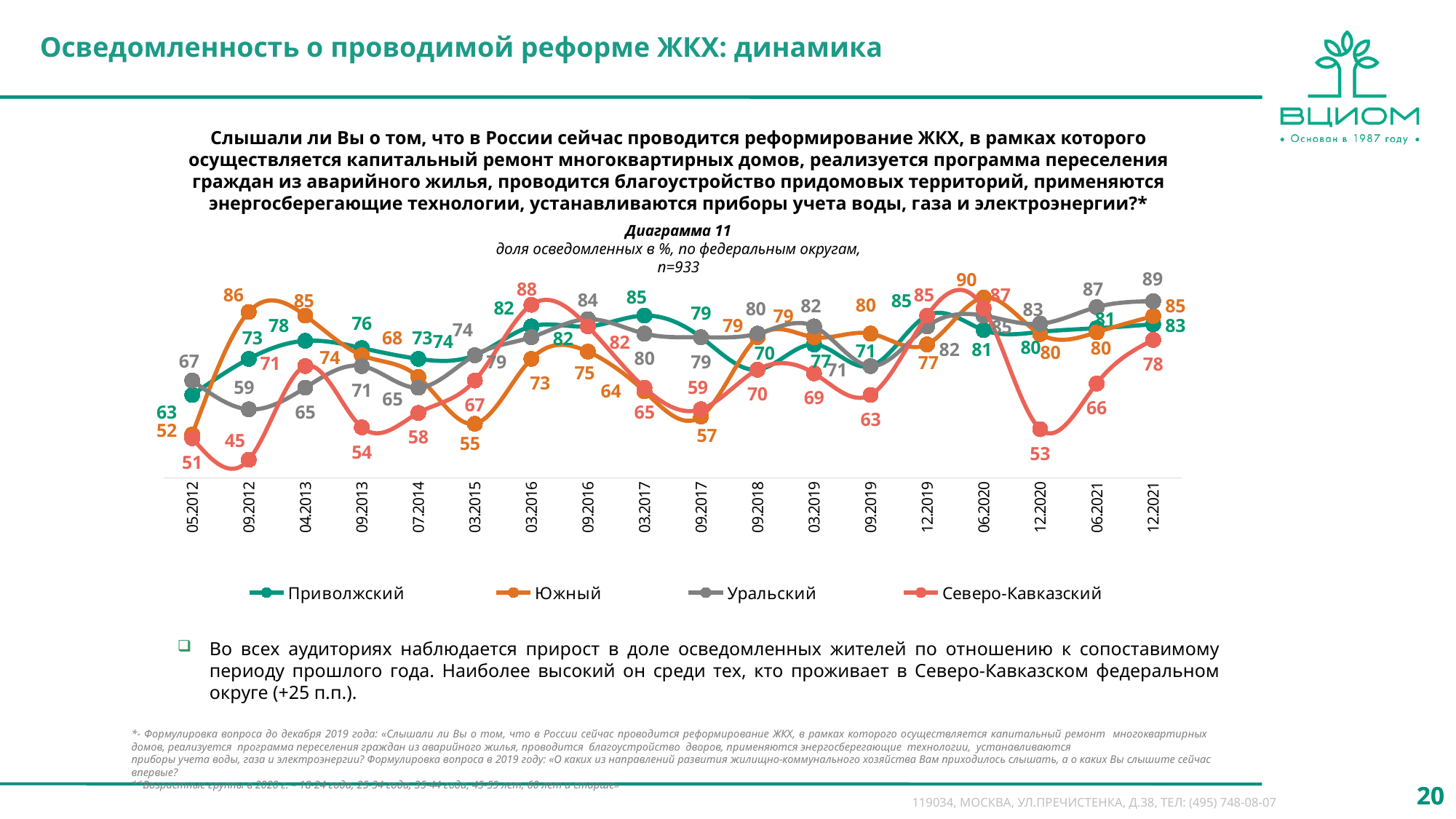
In which period does Северо-Кавказский have its lowest value? 09.2012 What is the value for Южный in 09.2012? 86 What colour is the Южный series in the legend? orange In 12.2021, which is larger: the value for Уральский or for Северо-Кавказский? Уральский In which period does Северо-Кавказский reach its highest value? 03.2016 What is the value for Северо-Кавказский in 06.2020? 87 What is the value for Приволжский in 03.2017? 85 How many series does the legend list? 4 What is the value for Уральский in 12.2021? 89 How many time points are shown on the x axis? 18 What kind of chart is shown on the slide? line chart What is the difference between the Северо-Кавказский values in 12.2021 and 12.2020? 25